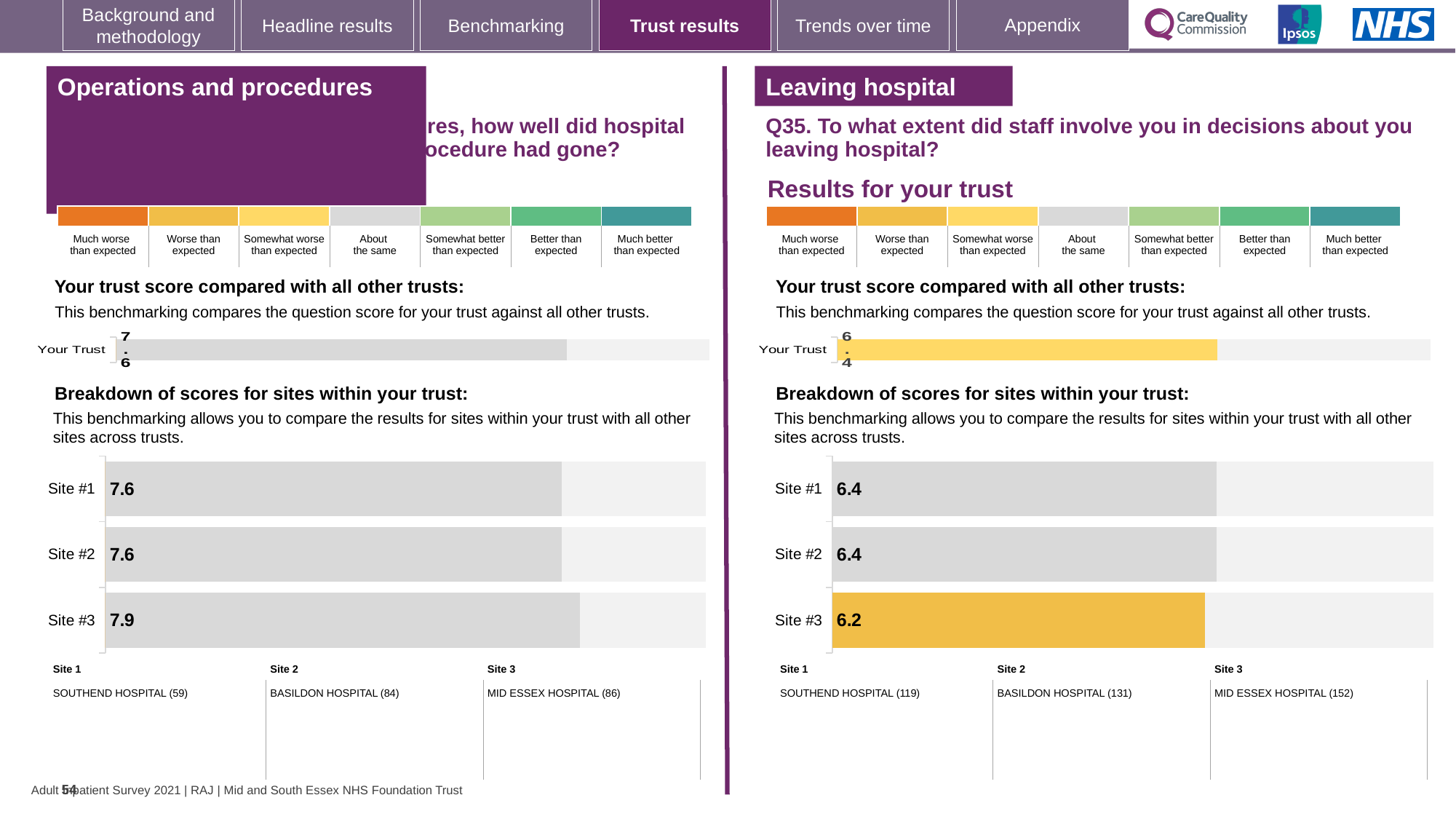
In the 'Leaving hospital' section, what is the trust score shown in the 'Your trust score compared with all other trusts' chart? 6.4 What type of chart is used for the site breakdown in the 'Leaving hospital' section? Bar chart In the 'Operations and procedures' site breakdown chart, which site has the highest score? Site #3 In the 'Leaving hospital' site breakdown chart, what is the score for Site #3? 6.2 In the 'Operations and procedures' site breakdown chart, what is the difference between the scores for Site #3 and Site #2? 0.3 In the 'Operations and procedures' section, what is the trust score shown in the 'Your trust score compared with all other trusts' chart? 7.6 In the 'Operations and procedures' site breakdown chart, what is the score for Site #3? 7.9 In the 'Operations and procedures' site breakdown chart, what is the score for Site #1? 7.6 In the 'Leaving hospital' site breakdown chart, which site has the lowest score? Site #3 In the 'Leaving hospital' site breakdown chart, what is the difference between the scores for Site #1 and Site #3? 0.2 In the 'Leaving hospital' site breakdown chart, which site's bar is coloured yellow rather than grey? Site #3 In the 'Leaving hospital' site breakdown chart, how many sites are shown? 3